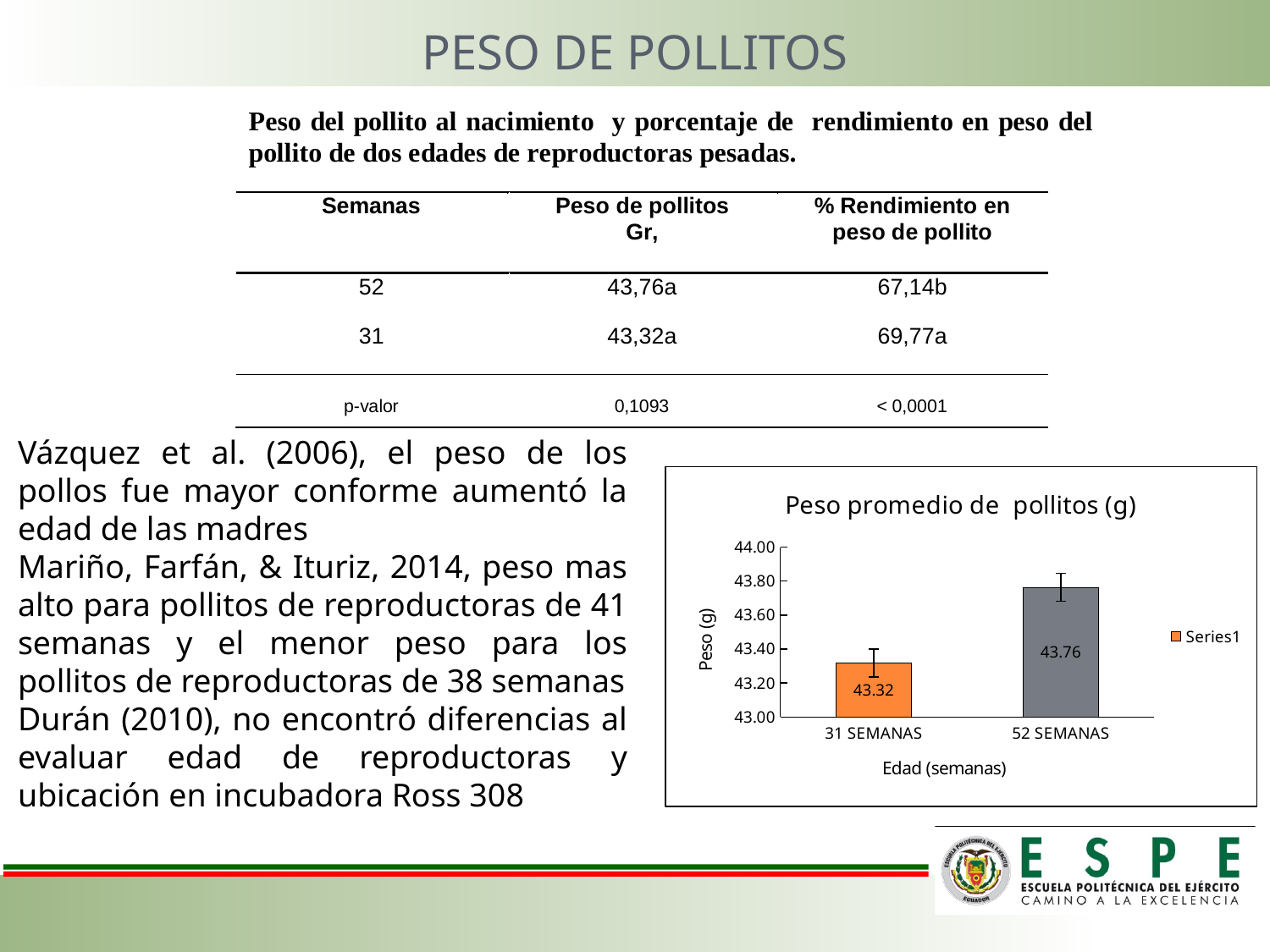
Which is larger, the value for 31 SEMANAS or 52 SEMANAS? 52 SEMANAS Is the value for 31 SEMANAS greater or less than 43.40? less Which category has the highest value in the chart? 52 SEMANAS What is the value for 52 SEMANAS in the chart? 43.76 How many series does the chart legend list? 1 How many categories are shown on the x axis of the chart? 2 What kind of chart is shown on the slide? bar chart What is the difference between the values for 52 SEMANAS and 31 SEMANAS? 0.44 What is the title of the chart? Peso promedio de pollitos (g) Is the value for 52 SEMANAS greater or less than 43.60? greater What is the value for 31 SEMANAS in the chart? 43.32 Which category has the lowest value in the chart? 31 SEMANAS